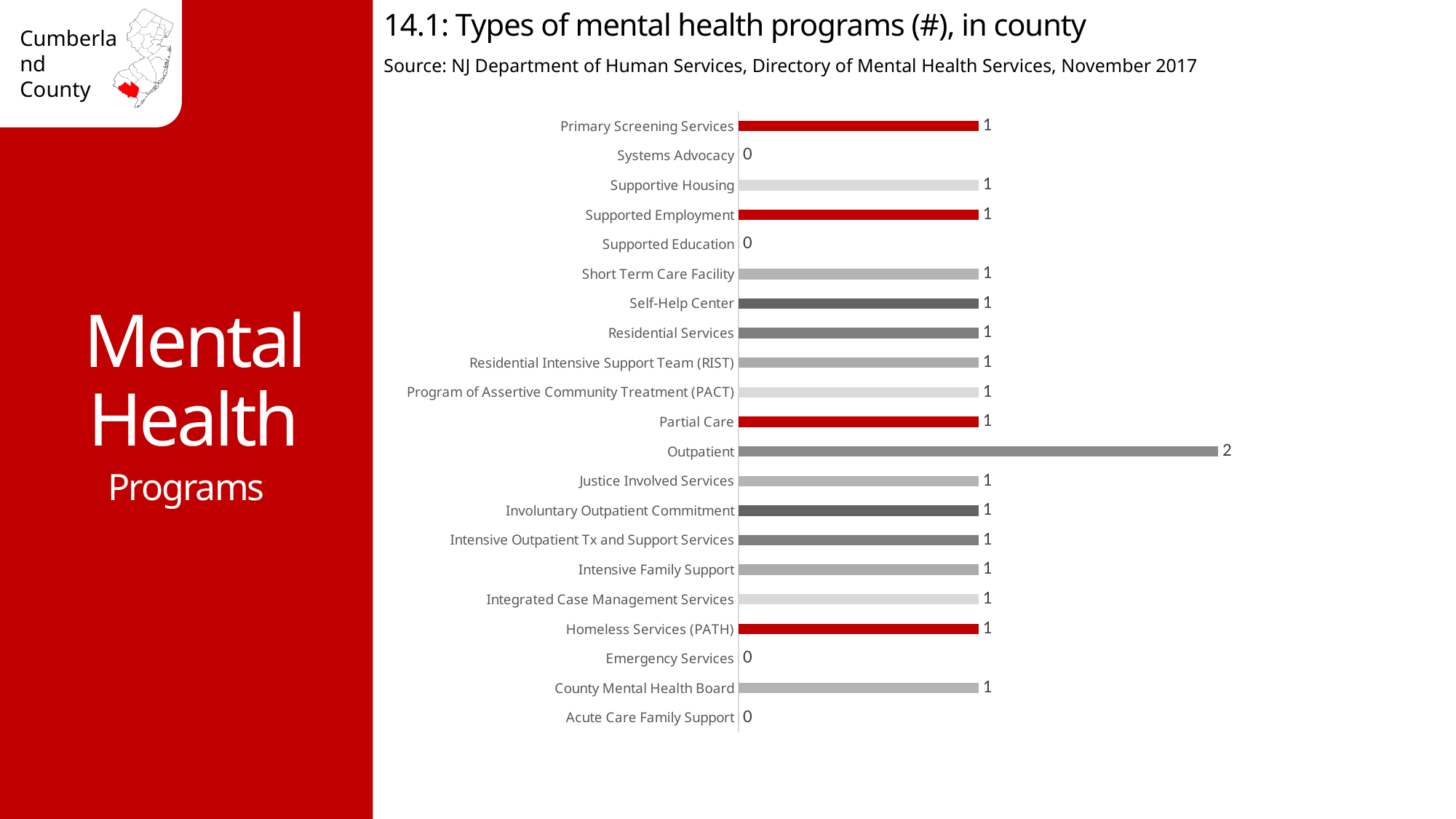
What is the value for Outpatient? 2 What is the difference between the values for Outpatient and Partial Care? 1 What is the title of the chart? 14.1: Types of mental health programs (#), in county Which is larger, the value for Supported Employment or the value for Supported Education? Supported Employment What kind of chart is this? Bar chart What is the value for Homeless Services (PATH)? 1 Which category has the highest value? Outpatient What is the value for Emergency Services? 0 What is the value for Systems Advocacy? 0 How many categories have a value of 0? 4 What is the source cited for the chart? NJ Department of Human Services, Directory of Mental Health Services, November 2017 How many categories are shown on the chart? 21